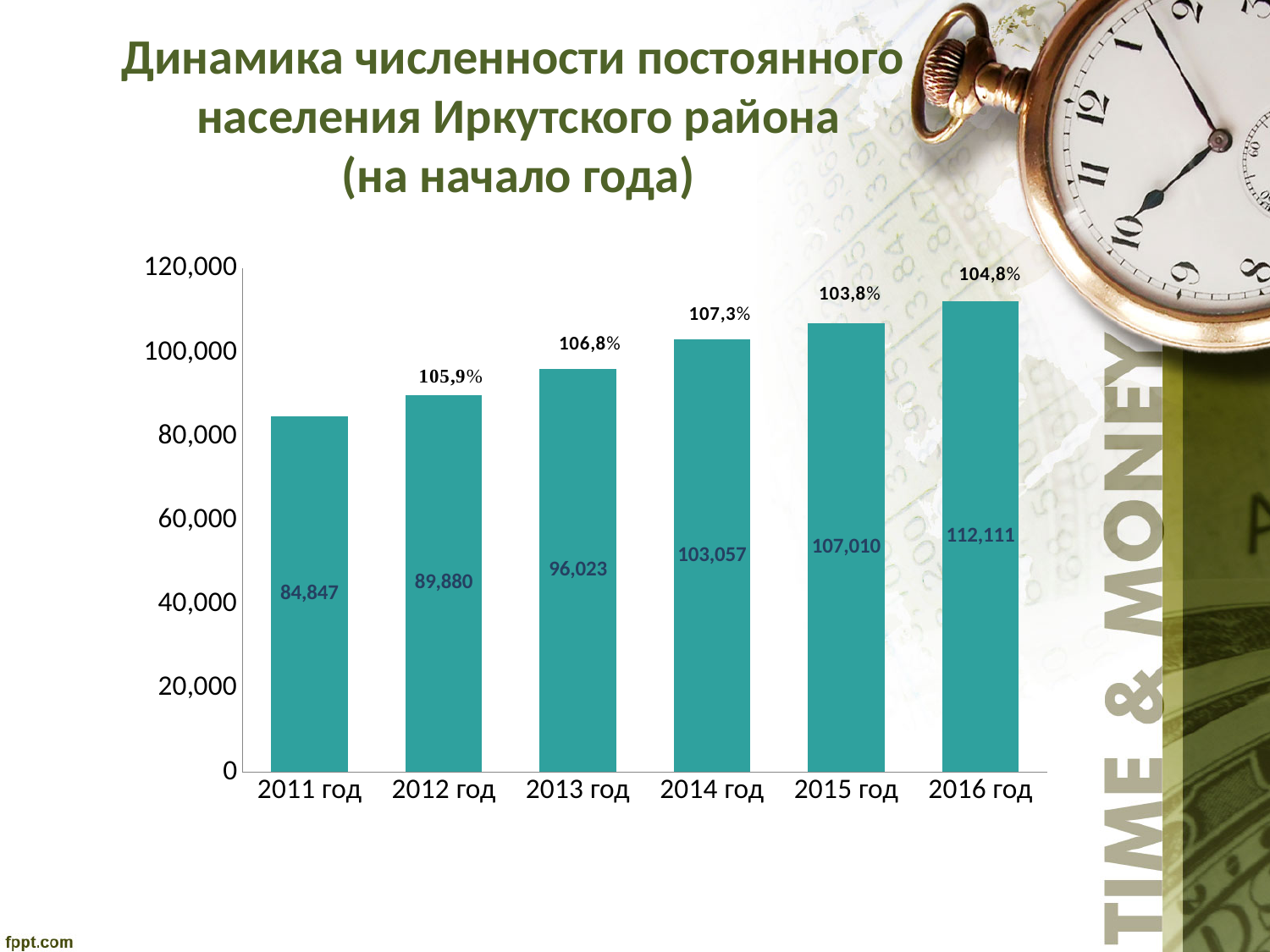
What is the difference between the population values for 2016 год and 2011 год? 27,264 What is the population value shown for 2016 год? 112,111 Which is larger, the population value for 2014 год or for 2015 год? 2015 год What is the population value shown for 2014 год? 103,057 Do the population values rise or fall from 2011 год to 2016 год? rise What percentage label is printed above the bar for 2015 год? 103,8% What percentage label is printed above the bar for 2013 год? 106,8% Which year has the lowest population value? 2011 год Which year has the highest population value? 2016 год What is the difference between the population values for 2013 год and 2012 год? 6,143 How many years are shown on the x axis? 6 What is the population value shown for 2011 год? 84,847